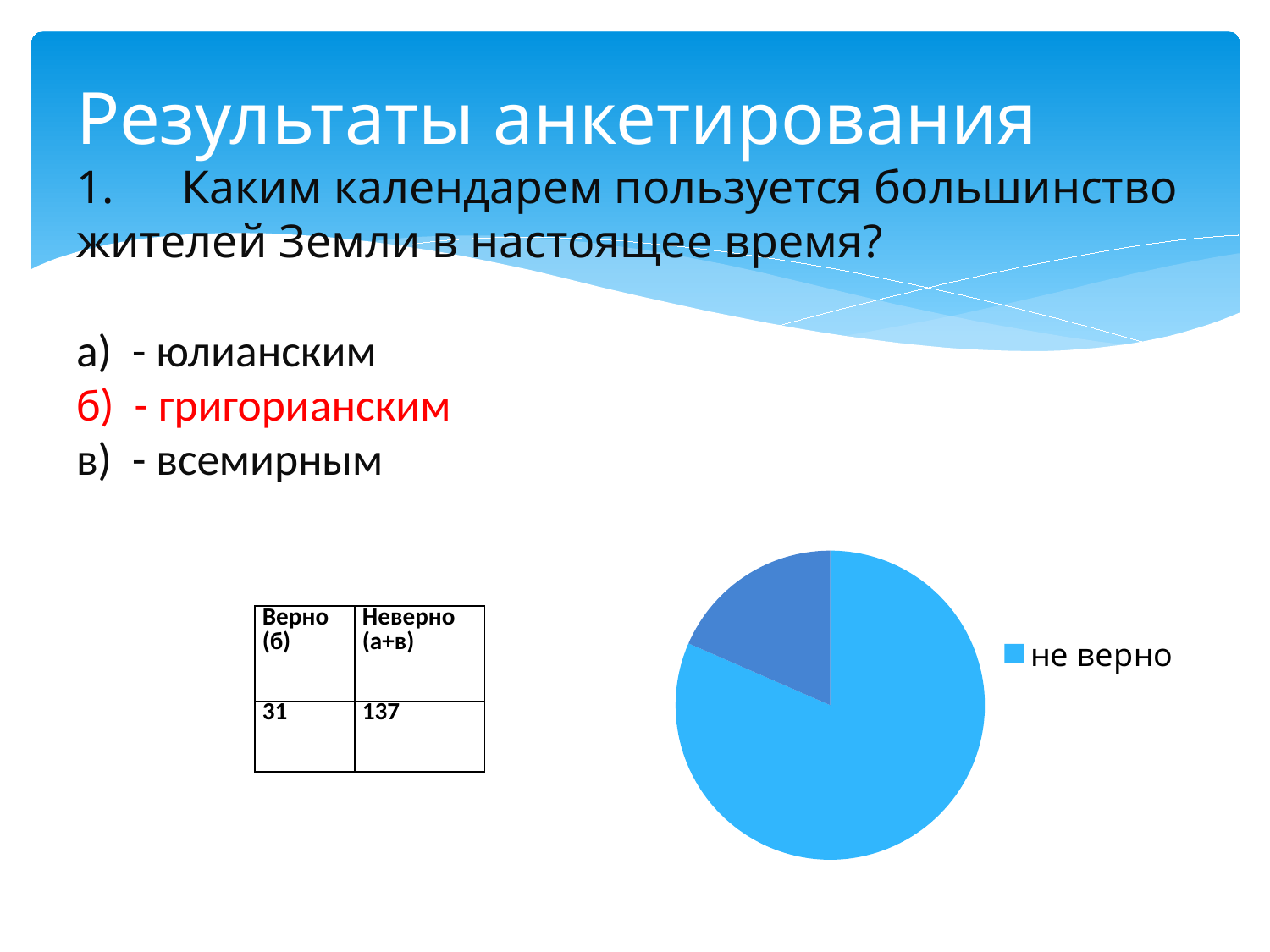
How many slices does the pie chart have? 2 Does the slice labelled "не верно" take up more or less than half of the pie chart? more What kind of chart is shown on the slide? pie chart How many entries does the legend of the pie chart list? 1 What colour is the slice labelled "не верно" in the pie chart? light blue Which slice of the pie chart is larger: the light blue slice labelled "не верно" or the darker blue slice? the light blue slice labelled "не верно" What is the entry shown in the legend of the pie chart? не верно